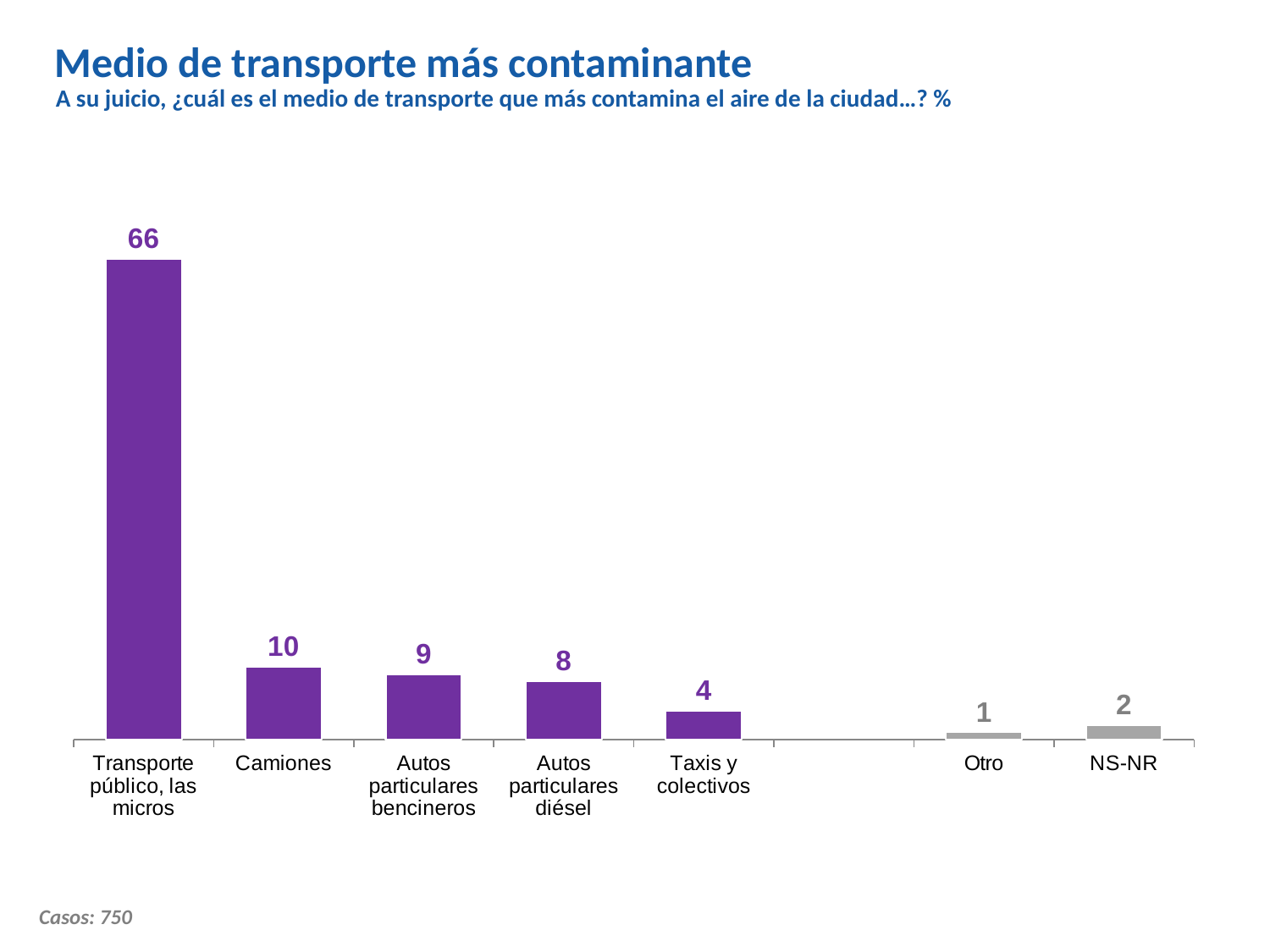
How many bars are plotted on the chart? 7 Which is larger, the value for Camiones or the value for Autos particulares bencineros? Camiones What is the value for Camiones? 10 What is the title of the chart? Medio de transporte más contaminante What is the value for Autos particulares diésel? 8 Which category has the lowest value? Otro Which category has the highest value? Transporte público, las micros What is the difference between the values for Transporte público, las micros and Camiones? 56 What is the difference between the values for Autos particulares bencineros and Taxis y colectivos? 5 What kind of chart is shown on the slide? Bar chart What is the value for NS-NR? 2 What is the value for Transporte público, las micros? 66